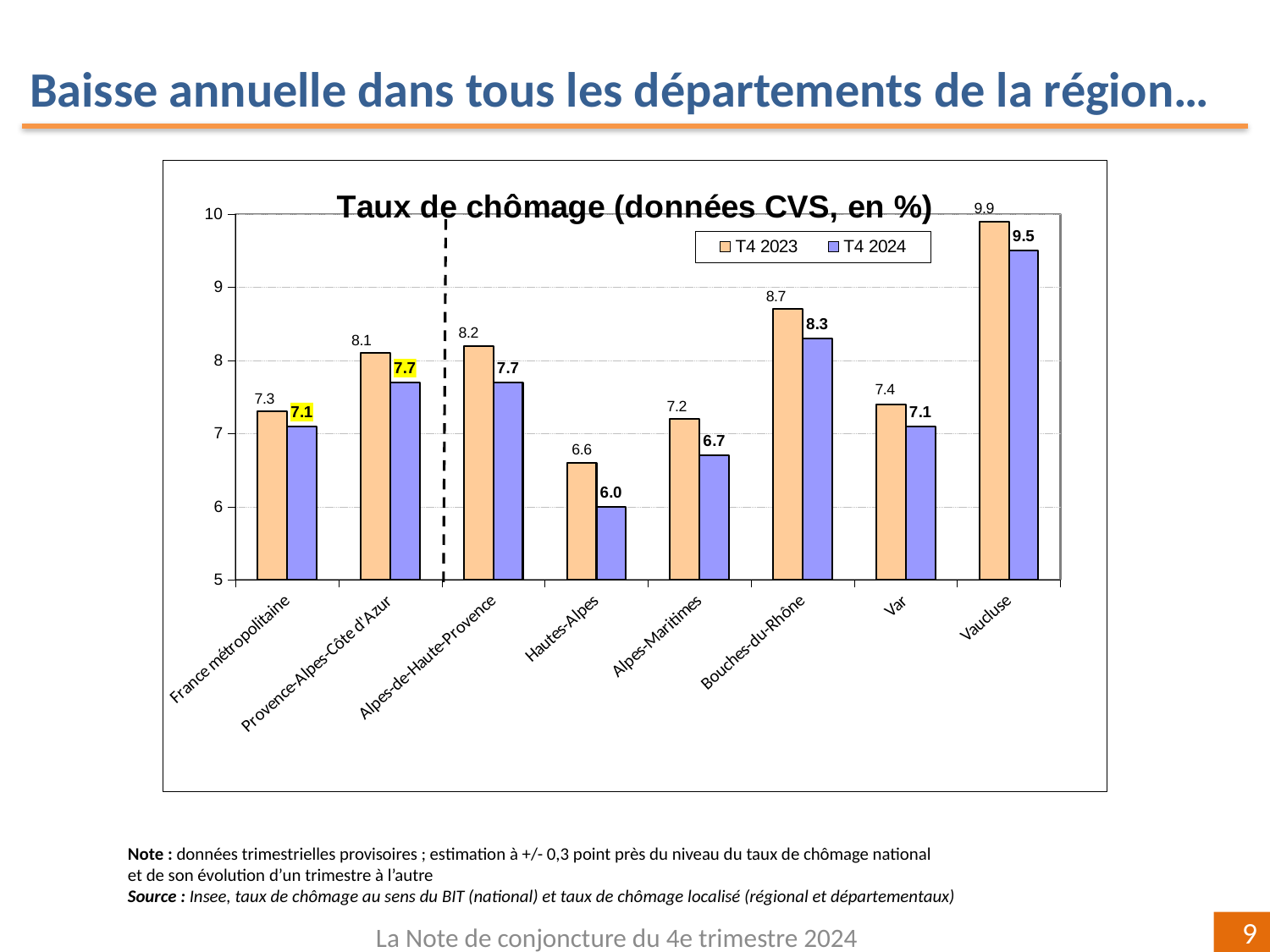
What is the T4 2023 unemployment rate for Hautes-Alpes? 6.6 What kind of chart is shown? Bar chart Which is larger: the T4 2024 value for Alpes-Maritimes or the T4 2024 value for Var? Var Which category has the lowest T4 2024 unemployment rate? Hautes-Alpes Which category has the highest T4 2023 unemployment rate? Vaucluse What is the difference between the T4 2023 and T4 2024 values for Hautes-Alpes? 0.6 What is the T4 2024 value for Bouches-du-Rhône? 8.3 How many series does the legend list? 2 What is the title of the chart? Taux de chômage (données CVS, en %) How many categories are shown on the x axis? 8 Is the T4 2023 value for Bouches-du-Rhône greater or less than 8? greater What is the T4 2024 unemployment rate for Vaucluse? 9.5